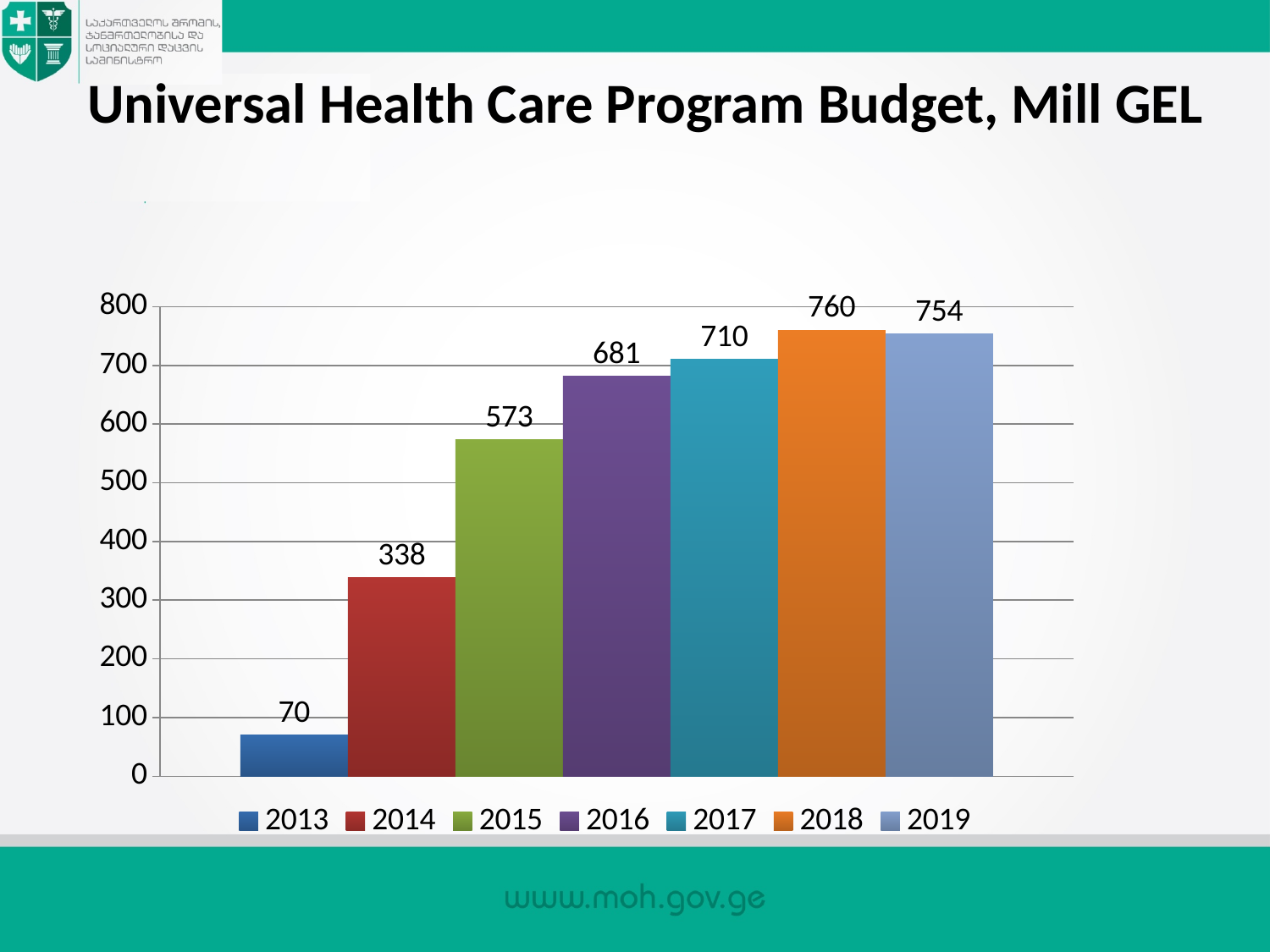
What is the budget value shown for 2019? 754 Is the value for 2014 greater or less than 300? greater Which is larger, the budget for 2015 or the budget for 2017? 2017 What is the title of the chart? Universal Health Care Program Budget, Mill GEL How many years are shown in the chart? 7 Which year has the lowest budget? 2013 What is the budget value shown for 2016? 681 What is the difference between the 2018 and 2019 budgets? 6 By how much did the budget increase from 2014 to 2015? 235 Which year has the highest budget? 2018 What kind of chart is shown on the slide? Bar chart What is the Universal Health Care Program budget for 2013? 70